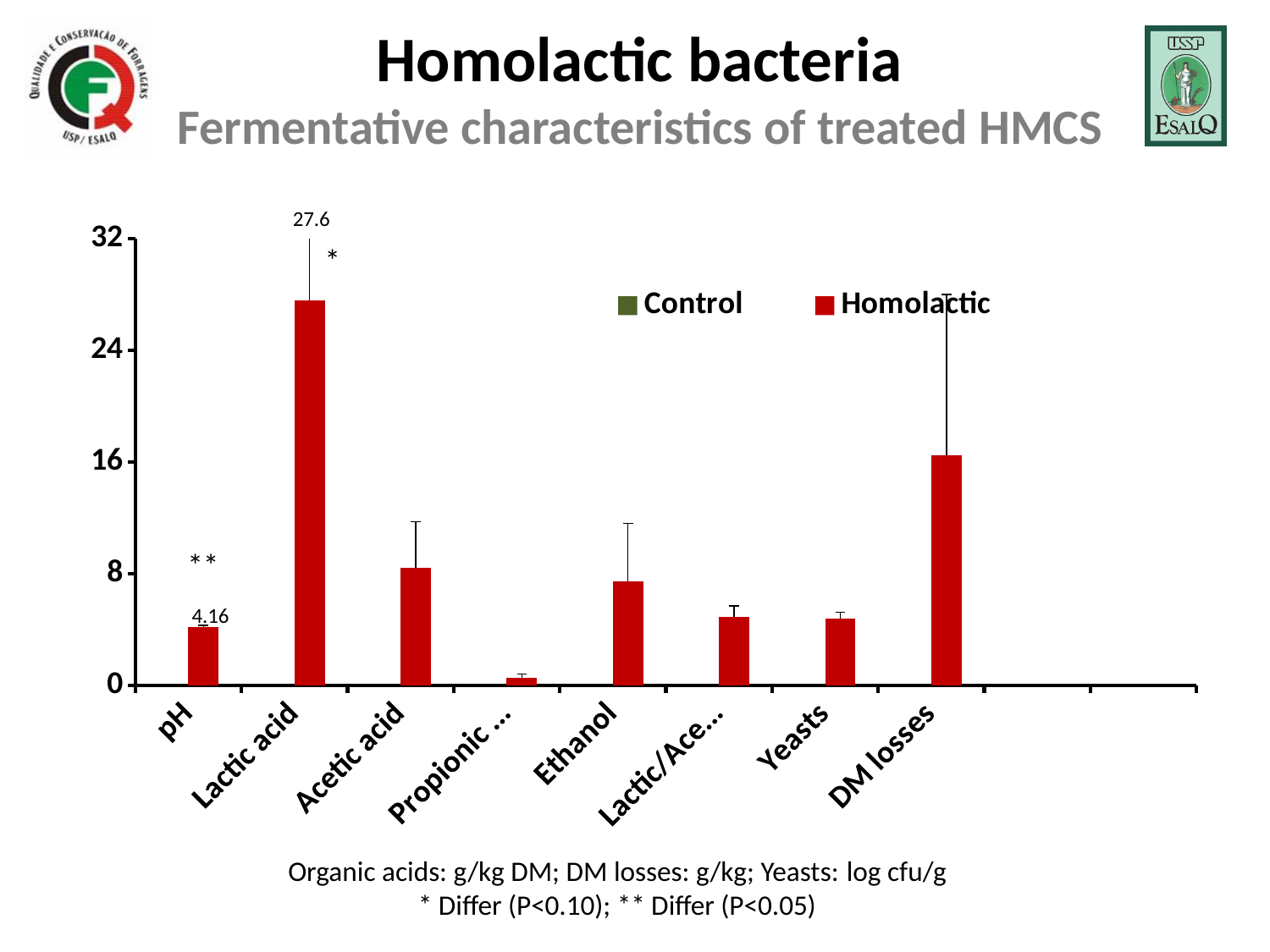
Is the value for DM losses greater or less than 8? greater Is the value for Acetic acid greater or less than 16? less Which bar is taller, Lactic acid or DM losses? Lactic acid Which category has the highest bar? Lactic acid How many series does the legend list? 2 How many categories are shown on the x axis? 8 What kind of chart is shown on the slide? bar chart Which bar is taller, Acetic acid or Yeasts? Acetic acid What is the difference between the Lactic acid value and the pH value? 23.44 Is the value for Yeasts greater or less than 8? less What is the value of the Lactic acid bar? 27.6 What is the value of the pH bar? 4.16